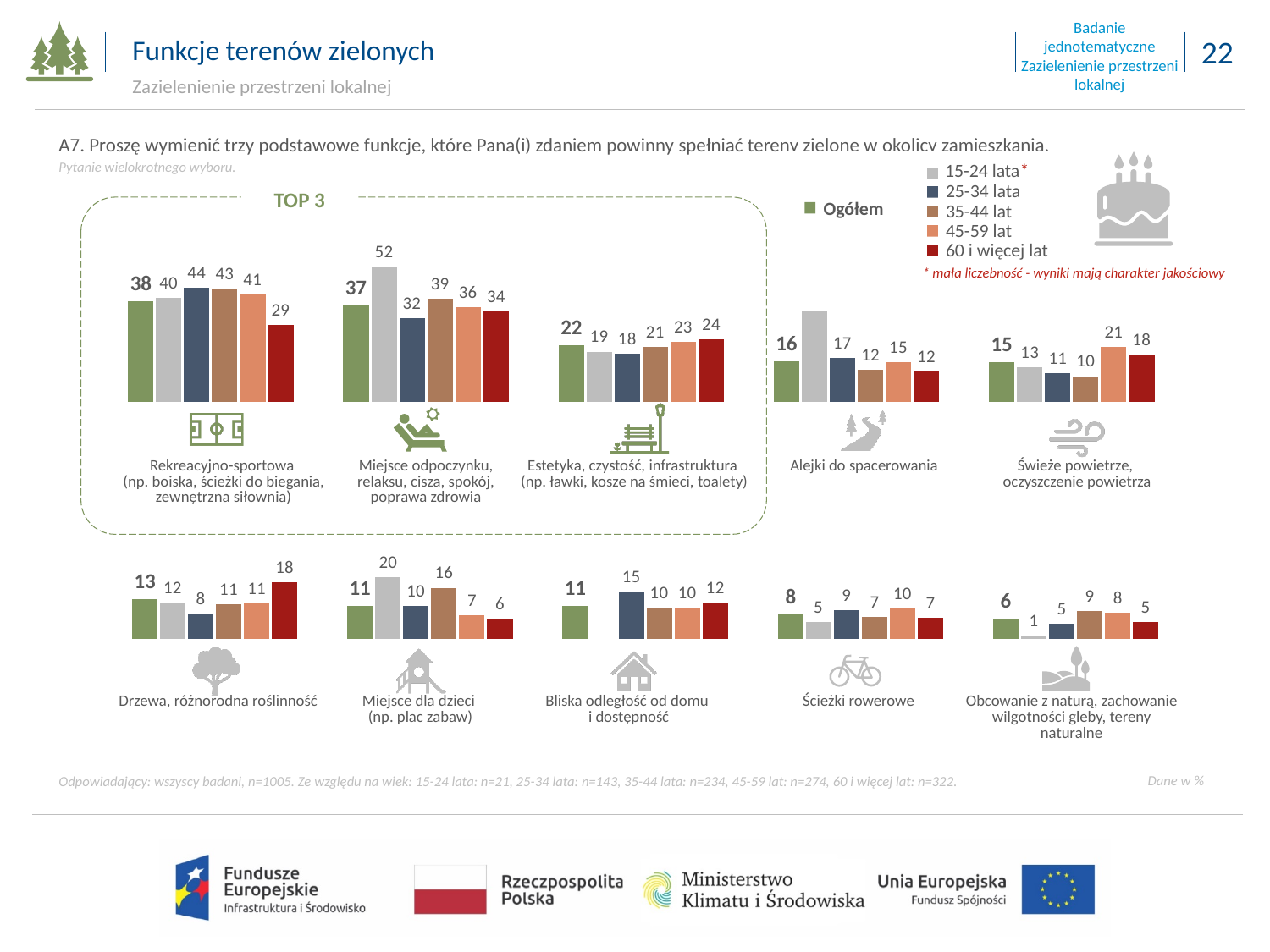
In the chart for "Rekreacyjno-sportowa", which age group has the lowest value? 60 i więcej lat In the chart for "Miejsce dla dzieci (np. plac zabaw)", what is the value for 35-44 lat? 16 In the chart for "Miejsce odpoczynku, relaksu, cisza, spokój, poprawa zdrowia", which age group has the highest value? 15-24 lata In the chart for "Rekreacyjno-sportowa", what is the value for Ogółem? 38 In the chart for "Obcowanie z naturą, zachowanie wilgotności gleby, tereny naturalne", what is the value for 15-24 lata? 1 Which three functions are grouped in the "TOP 3" box? Rekreacyjno-sportowa; Miejsce odpoczynku, relaksu, cisza, spokój, poprawa zdrowia; Estetyka, czystość, infrastruktura In the chart for "Świeże powietrze, oczyszczenie powietrza", what is the difference between the 45-59 lat value and the 35-44 lat value? 11 How many series does the legend list? 6 In the chart for "Drzewa, różnorodna roślinność", what is the value for 60 i więcej lat? 18 What kind of chart is used for "Ścieżki rowerowe"? bar chart In the chart for "Ścieżki rowerowe", what is the difference between the 45-59 lat value and the 15-24 lata value? 5 In the chart for "Estetyka, czystość, infrastruktura", which is larger: the value for 60 i więcej lat or the value for 25-34 lata? 60 i więcej lat